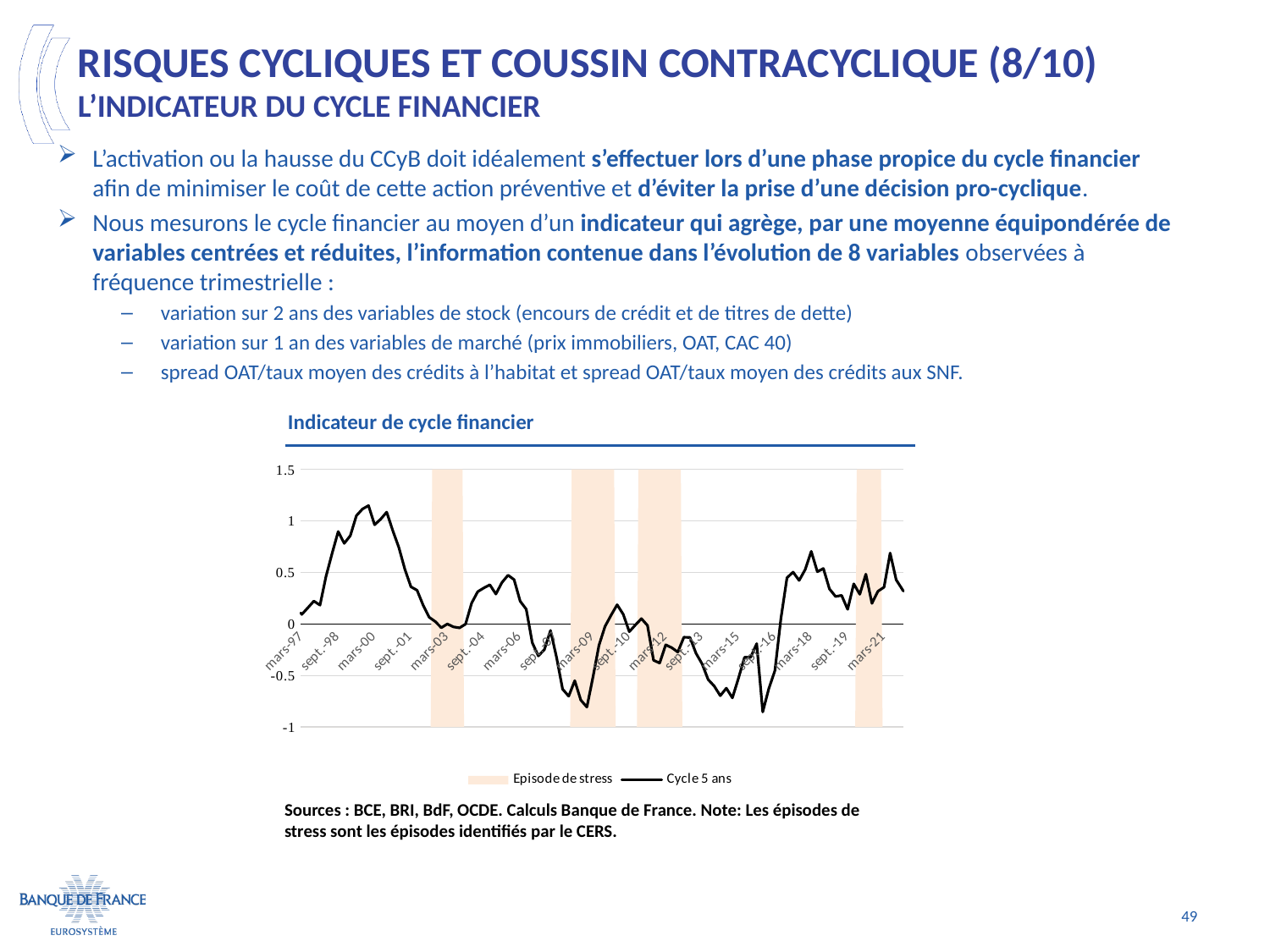
What is the highest value shown on the chart's vertical axis? 1.5 What is the title of the chart? Indicateur de cycle financier How many shaded 'Episode de stress' bands are shown on the chart? 4 What kind of chart is shown under the title 'Indicateur de cycle financier'? line chart Does the 'Cycle 5 ans' line rise or fall between mars-00 and mars-03? fall What are the two entries in the chart's legend? Episode de stress, Cycle 5 ans Is the value of 'Cycle 5 ans' at mars-00 greater or less than 0.5? greater How many series does the legend of the chart list? 2 Does the 'Cycle 5 ans' line rise or fall between mars-97 and mars-00? rise Is the value of 'Cycle 5 ans' at mars-97 greater or less than 0.5? less Is the value of 'Cycle 5 ans' at mars-18 greater or less than 0? greater